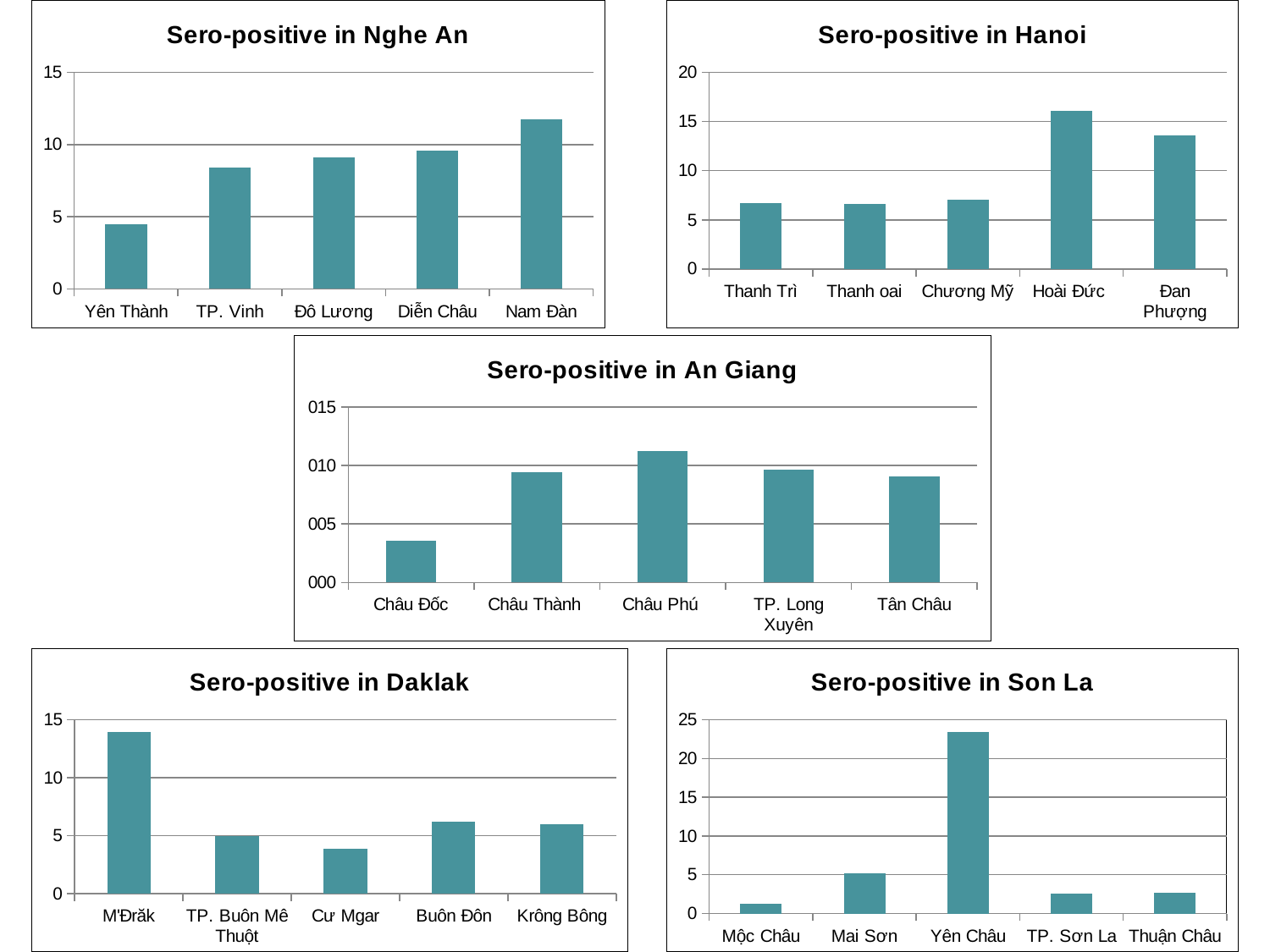
In the 'Sero-positive in Nghe An' chart, which district has the lowest value? Yên Thành In the 'Sero-positive in Hanoi' chart, which district has the highest value? Hoài Đức In the 'Sero-positive in Daklak' chart, is the value for Cư Mgar greater or less than 5? less In the 'Sero-positive in An Giang' chart, which district has the highest value? Châu Phú In the 'Sero-positive in An Giang' chart, which district has the lowest value? Châu Đốc In the 'Sero-positive in Hanoi' chart, is the value for Hoài Đức greater or less than 15? greater What type of chart is 'Sero-positive in Son La'? bar chart In the 'Sero-positive in Daklak' chart, which is larger, the value for M'Đrăk or the value for Buôn Đôn? M'Đrăk In the 'Sero-positive in Son La' chart, how many districts are shown on the x axis? 5 In the 'Sero-positive in Nghe An' chart, do the values rise or fall from left to right along the x axis? rise In the 'Sero-positive in Nghe An' chart, which district has the highest value? Nam Đàn